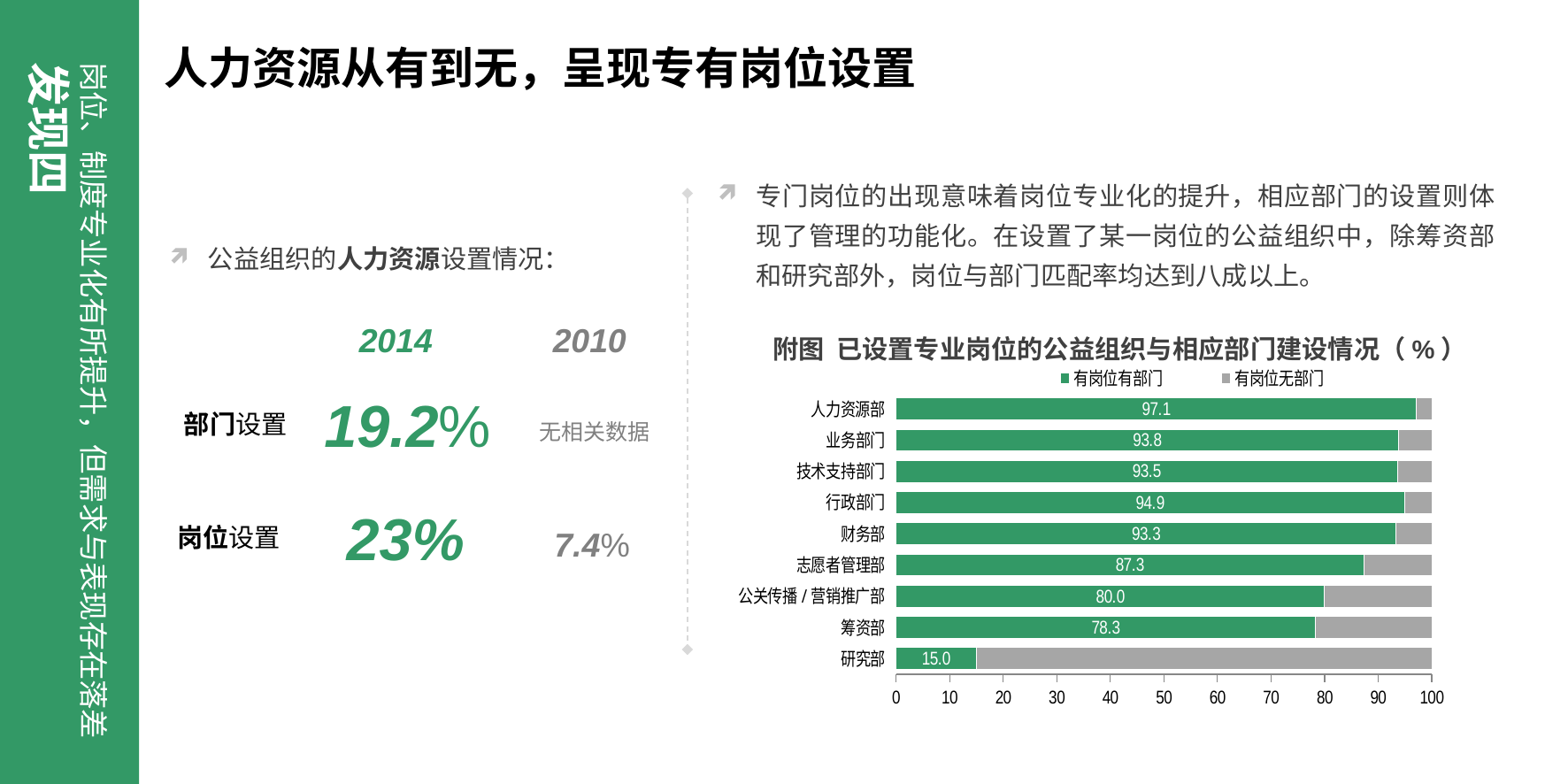
Which department has the highest 有岗位有部门 value? 人力资源部 What is the 有岗位有部门 value for 公关传播 / 营销推广部? 80.0 Which colour represents 有岗位无部门 in the chart? Grey How many series does the legend list? 2 What is the 有岗位有部门 value for 人力资源部? 97.1 How many departments are shown in the chart? 9 Which department has the lowest 有岗位有部门 value? 研究部 What is the 有岗位有部门 value for 研究部? 15.0 What type of chart is shown on the slide? Stacked horizontal bar chart Is the 有岗位无部门 value for 研究部 greater or less than 80? greater What is the difference between the 有岗位有部门 values of 人力资源部 and 筹资部? 18.8 Which has a larger 有岗位有部门 value, 志愿者管理部 or 筹资部? 志愿者管理部